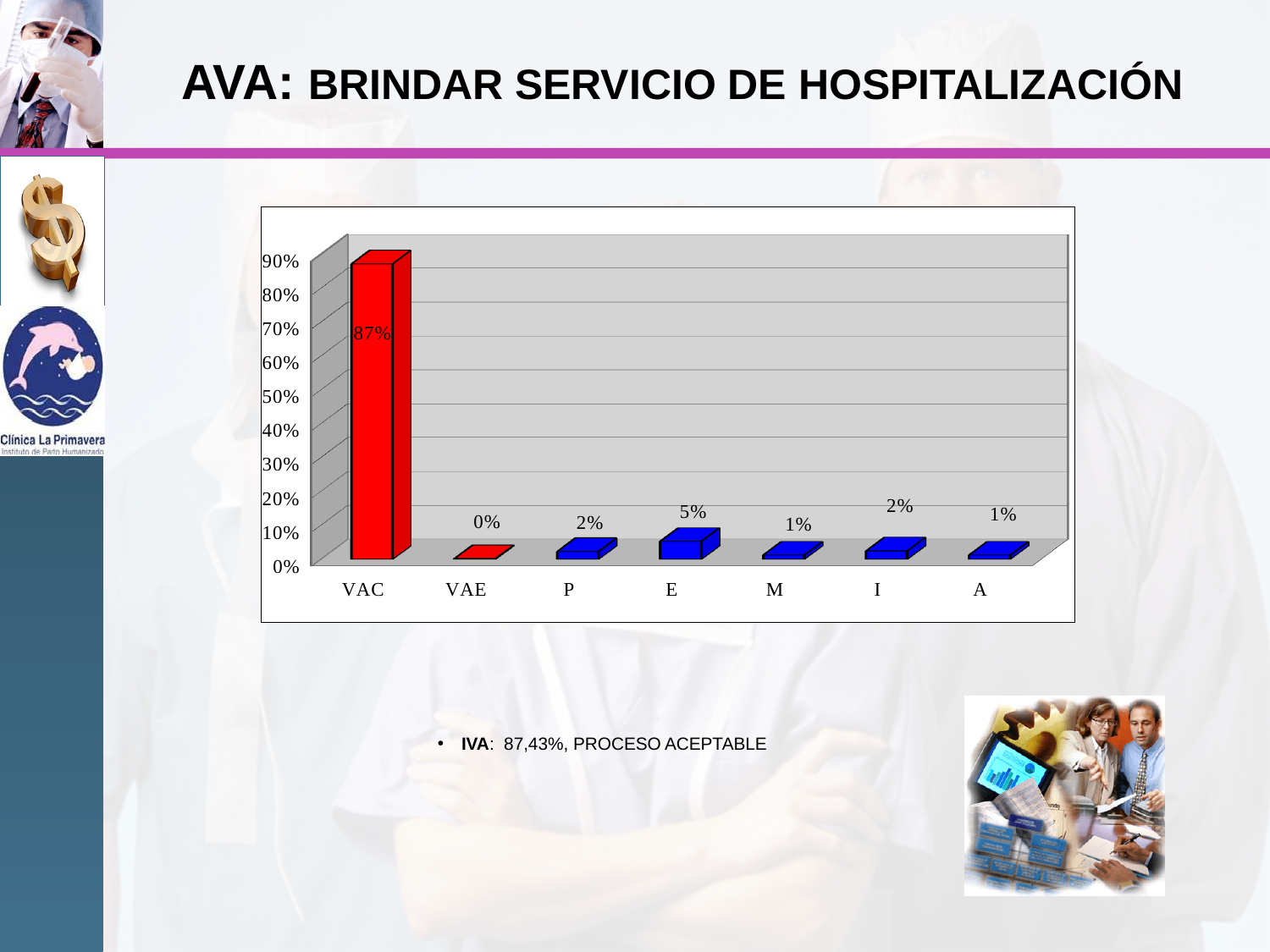
What is the value for E? 5% What is the difference between the values for VAC and E? 82% How many categories are shown on the x axis? 7 Which category has the lowest value? VAE Which is larger, the value for P or the value for E? E What kind of chart is shown on the slide? bar chart What is the value for M? 1% What colour is the bar for VAC? red Is the value for VAC greater or less than 80%? greater What is the value for VAC? 87% Which category has the highest value? VAC What is the value for VAE? 0%